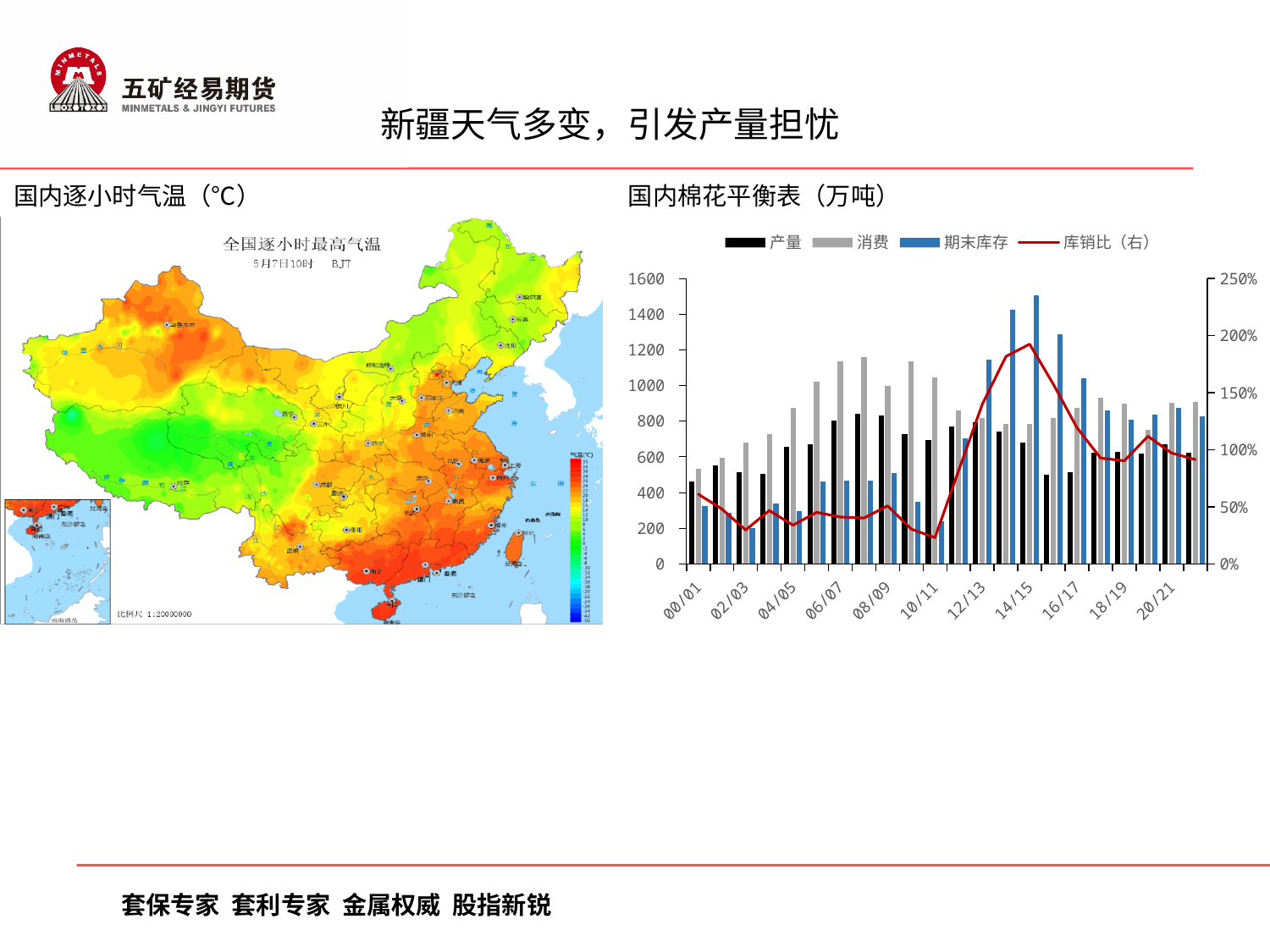
In the 国内棉花平衡表 chart, is the 期末库存 value for 02/03 greater or less than 400? less In the 国内棉花平衡表 chart, in which season does the 库销比 line reach its peak? 14/15 In the 国内棉花平衡表 chart, how many season labels are shown on the x axis? 11 What kind of chart is the 国内棉花平衡表 chart? Bar chart with a line series In the 国内棉花平衡表 chart, is the 期末库存 value for 14/15 greater or less than 1400? greater What is the title of the chart on the right side of the slide? 国内棉花平衡表（万吨） In the 国内棉花平衡表 chart, which series is plotted as a line rather than bars? 库销比（右） In the 国内棉花平衡表 chart, is the 库销比 value for 10/11 greater or less than 50%? less In the 国内棉花平衡表 chart, which is larger for 06/07: 产量 or 消费? 消费 In the 国内棉花平衡表 chart, how many series does the legend list? 4 In the 国内棉花平衡表 chart, in which season does 期末库存 reach its highest value? 14/15 In the 国内棉花平衡表 chart, does 期末库存 rise or fall from 10/11 to 14/15? rise